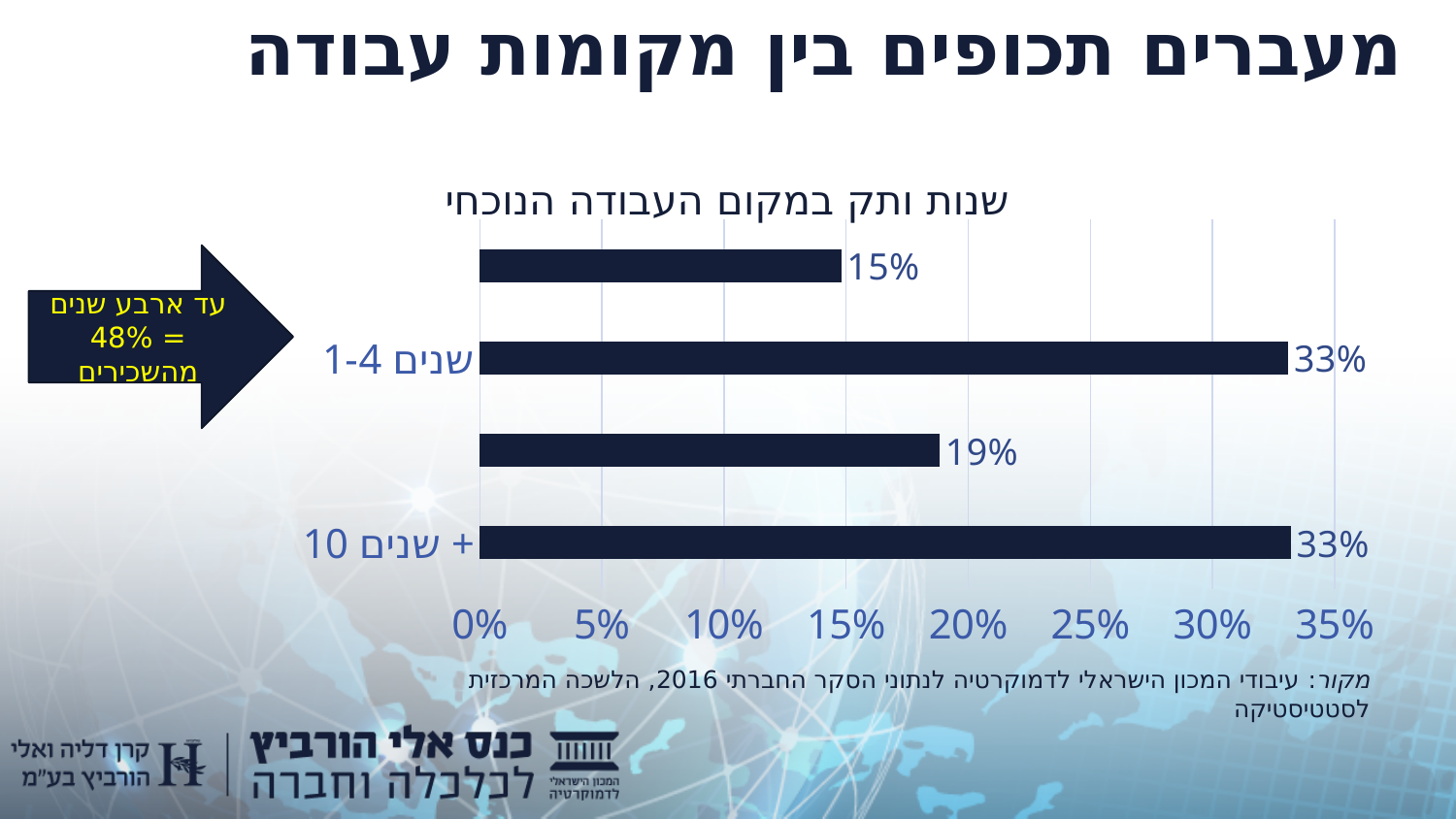
What is the difference between the third bar from the top (19%) and the top bar (15%)? 4 percentage points What is the largest value shown in the chart? 33% What is the title of the chart? שנות ותק במקום העבודה הנוכחי What is the value of the third bar from the top? 19% What is the smallest value shown in the chart? 15% What is the value for the category "10 שנים +"? 33% What is the difference between the value for "1-4 שנים" and the value of the top bar? 18 percentage points How many bars are plotted in the chart? 4 What kind of chart is shown on the slide? Bar chart Which is larger: the value for "1-4 שנים" or the value of the third bar from the top? 1-4 שנים What is the value for the category "1-4 שנים"? 33% What is the value of the top bar in the chart? 15%